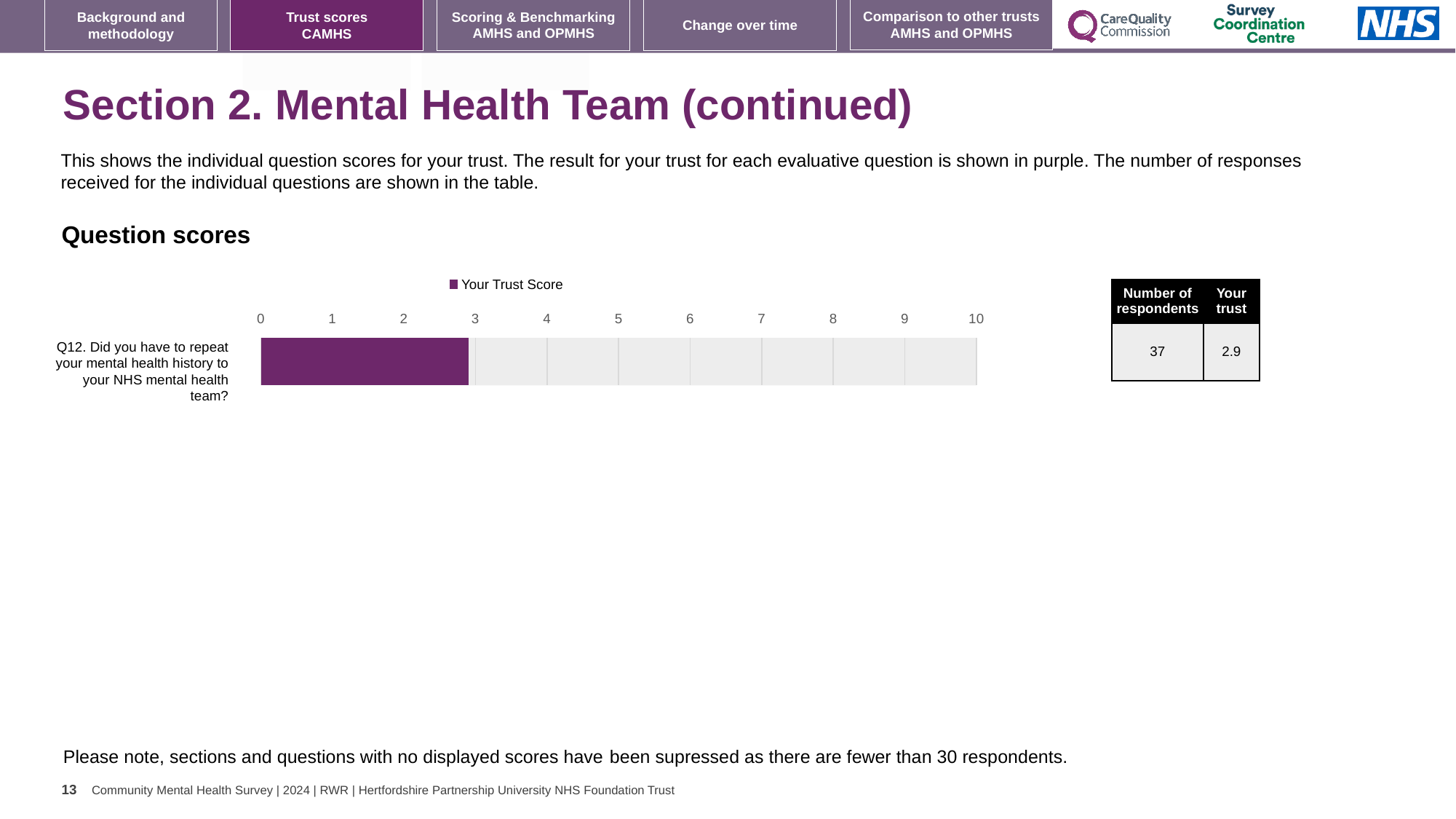
What is the maximum value shown on the chart's x axis? 10 Is the value for Q12 greater or less than 2? greater What colour is the bar for Your Trust Score? purple How many respondents answered Q12 according to the table? 37 Is the value for Q12 greater or less than 5? less How many questions (categories) are plotted in the chart? 1 What is the series name shown in the chart legend? Your Trust Score How many series does the chart legend list? 1 What is the trust score for Q12 (Did you have to repeat your mental health history to your NHS mental health team?)? 2.9 What kind of chart is shown under "Question scores"? bar chart